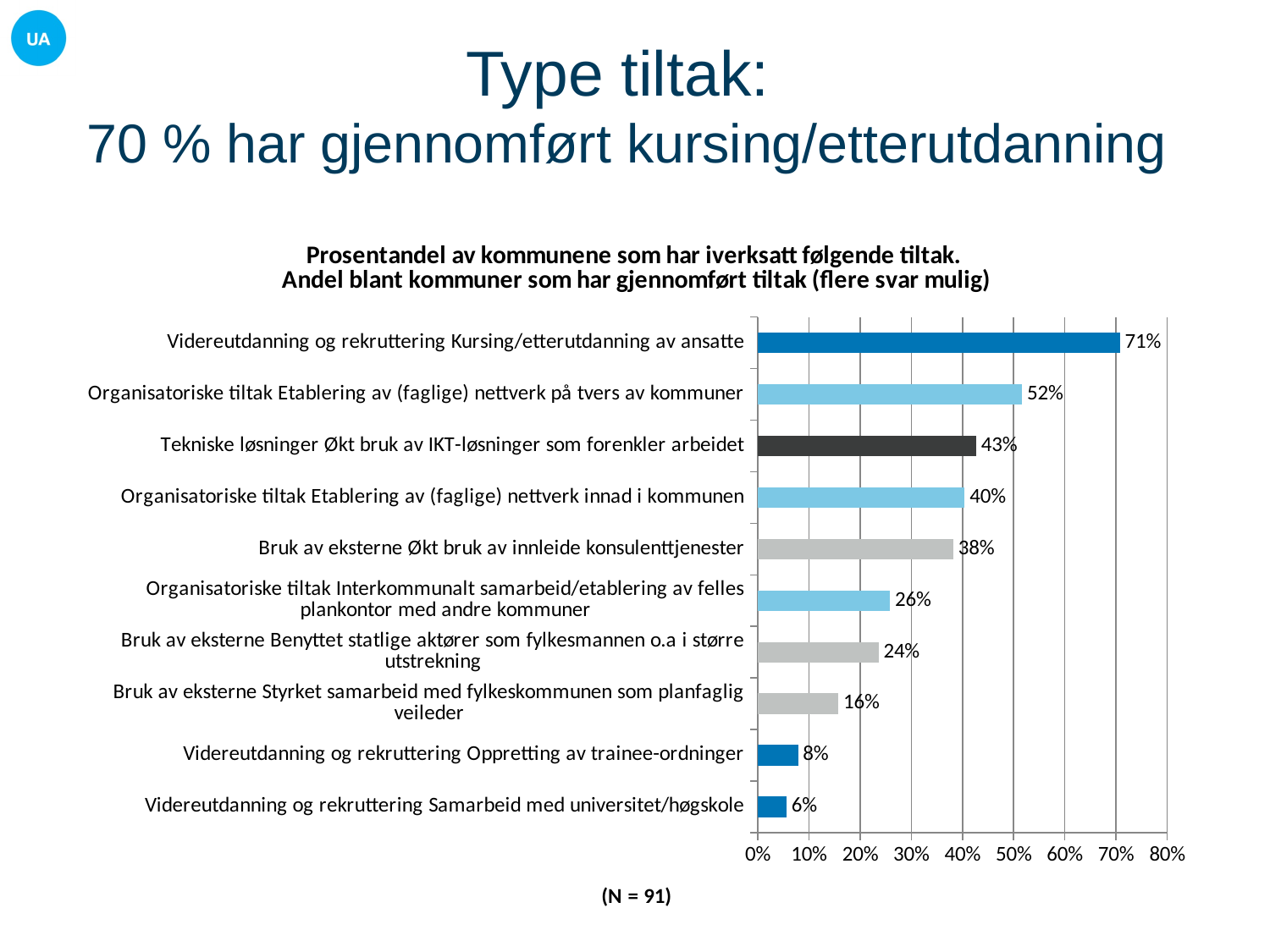
Which category has the lowest value in the chart? Videreutdanning og rekruttering Samarbeid med universitet/høgskole Is the value for 'Bruk av eksterne Benyttet statlige aktører som fylkesmannen o.a i større utstrekning' greater or less than 30%? less What percentage of municipalities implemented 'Videreutdanning og rekruttering Kursing/etterutdanning av ansatte'? 71% What is the value for 'Tekniske løsninger Økt bruk av IKT-løsninger som forenkler arbeidet'? 43% What is the sample size (N) stated below the chart? N = 91 What is the difference between the values for 'Videreutdanning og rekruttering Oppretting av trainee-ordninger' and 'Videreutdanning og rekruttering Samarbeid med universitet/høgskole'? 2% How many categories are shown in the chart? 10 Which category has the highest value in the chart? Videreutdanning og rekruttering Kursing/etterutdanning av ansatte What is the difference between the values for 'Organisatoriske tiltak Etablering av (faglige) nettverk på tvers av kommuner' and 'Organisatoriske tiltak Etablering av (faglige) nettverk innad i kommunen'? 12% Which is larger: the value for 'Bruk av eksterne Økt bruk av innleide konsulenttjenester' or 'Organisatoriske tiltak Interkommunalt samarbeid/etablering av felles plankontor med andre kommuner'? Bruk av eksterne Økt bruk av innleide konsulenttjenester What kind of chart is shown on the slide? bar chart What is the value for 'Bruk av eksterne Styrket samarbeid med fylkeskommunen som planfaglig veileder'? 16%